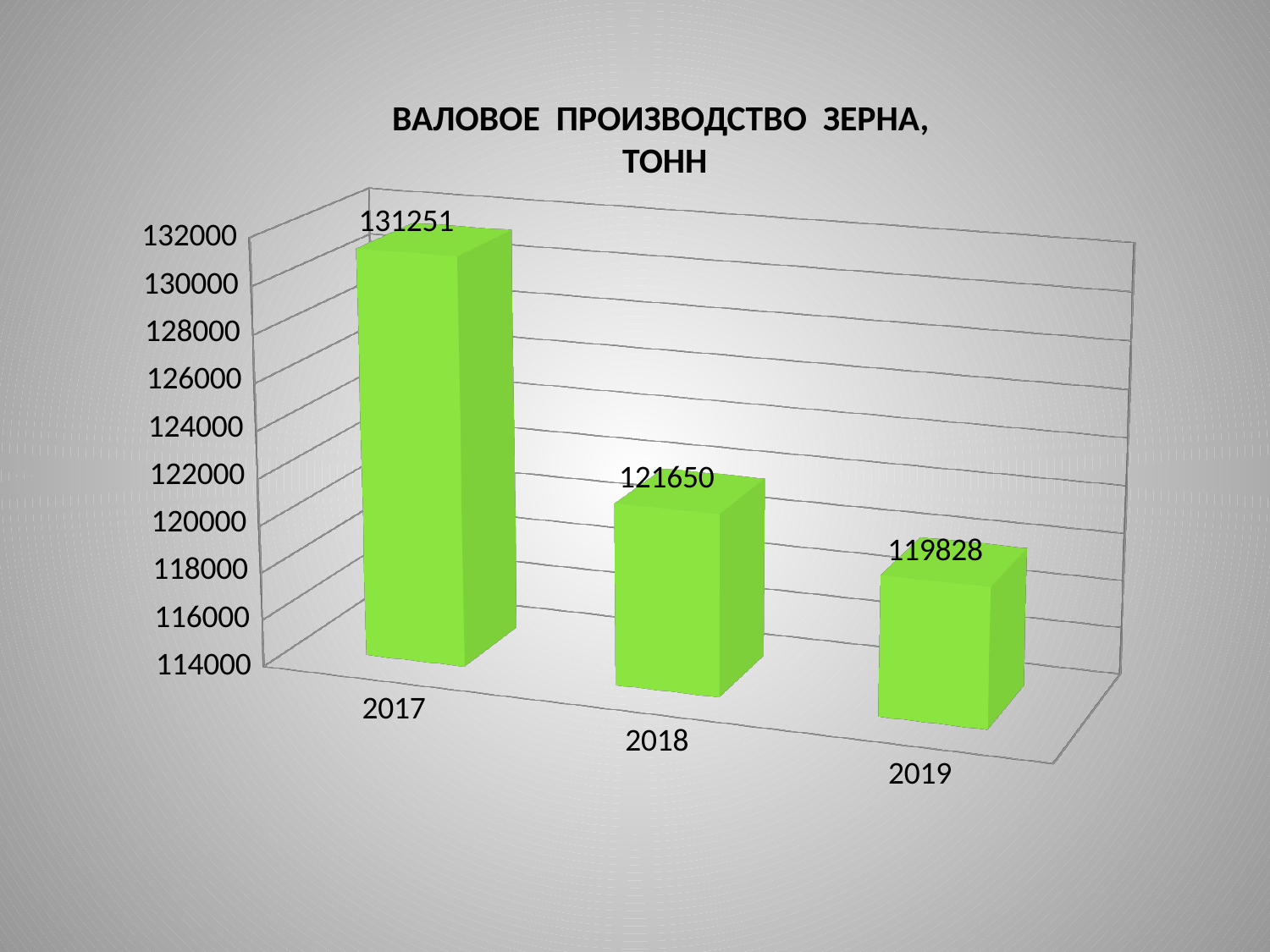
How many years are shown on the chart? 3 What is the value for 2017? 131251 Do the values rise or fall from 2017 to 2019? fall What is the value for 2018? 121650 What is the difference between the values for 2017 and 2018? 9601 What kind of chart is shown on the slide? bar chart Which is larger, the value for 2018 or the value for 2019? 2018 What is the difference between the values for 2018 and 2019? 1822 Which year has the highest value? 2017 What is the value for 2019? 119828 Which year has the lowest value? 2019 Is the value for 2019 greater or less than 120000? less